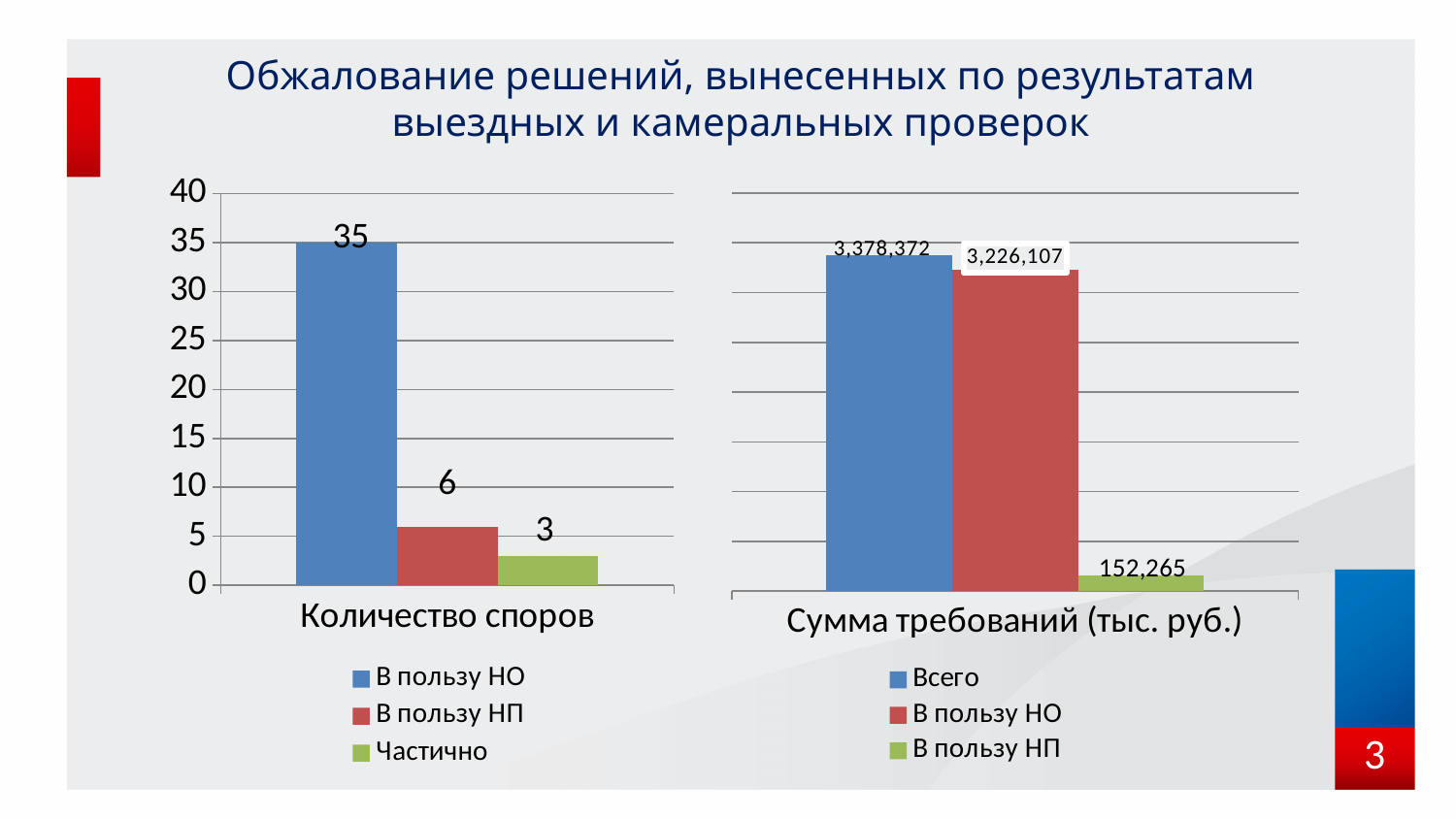
In the right chart (Сумма требований), what is the value for Всего? 3,378,372 In the left chart (Количество споров), which series has the lowest value? Частично In the right chart (Сумма требований), what is the value for В пользу НП? 152,265 What kind of chart is the left chart (Количество споров)? Bar chart In the left chart (Количество споров), how many series does the legend list? 3 In the right chart (Сумма требований), which series has the highest value? Всего In the left chart (Количество споров), what is the value for Частично? 3 What is the title of the slide? Обжалование решений, вынесенных по результатам выездных и камеральных проверок In the left chart (Количество споров), what is the value for В пользу НО? 35 In the left chart (Количество споров), what is the difference between В пользу НО and В пользу НП? 29 In the right chart (Сумма требований), which is larger: В пользу НО or В пользу НП? В пользу НО In the right chart (Сумма требований), what is the difference between Всего and В пользу НО? 152,265